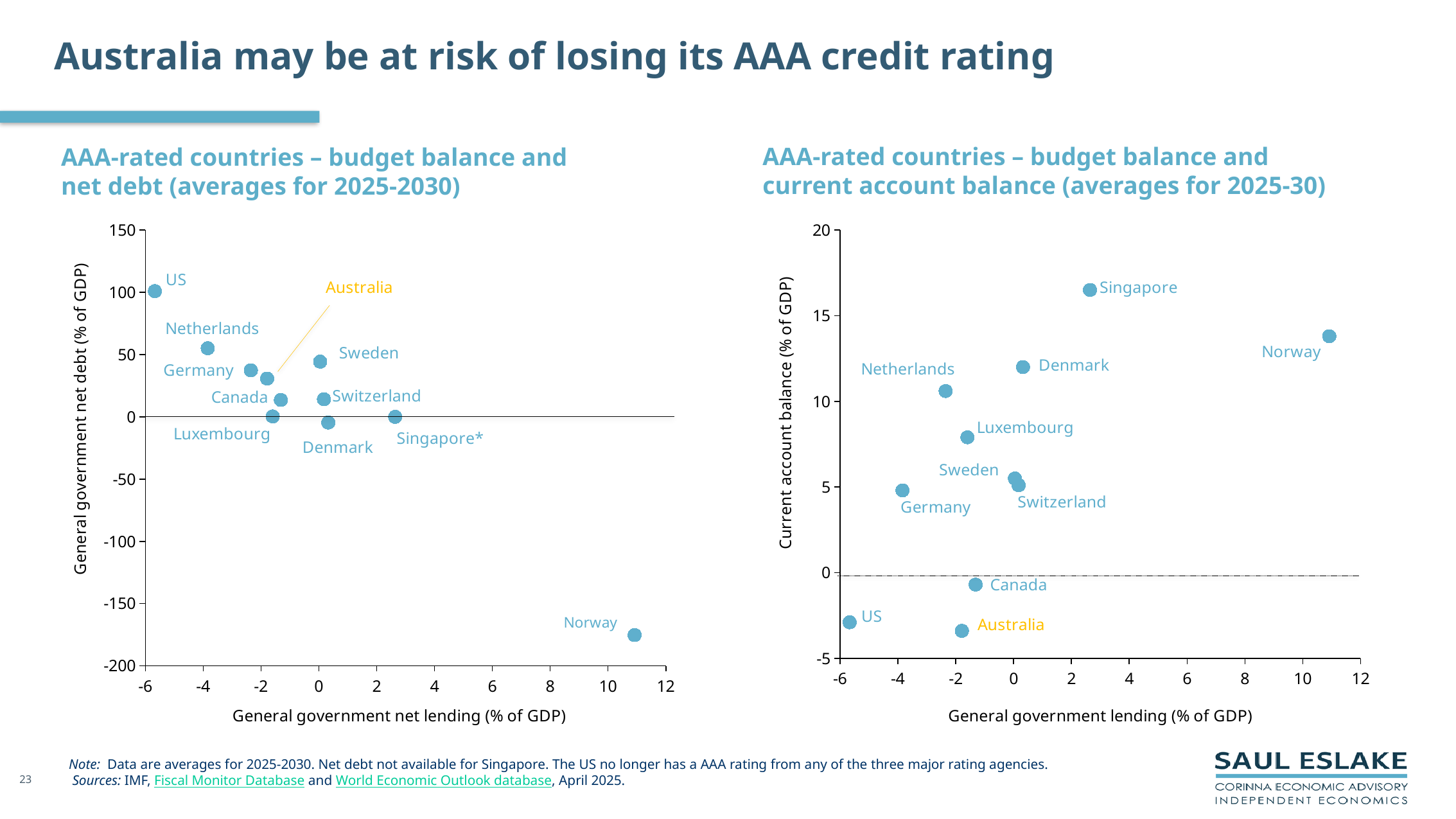
On the left chart (budget balance and net debt), is the net debt value for Norway greater or less than -150? less What kind of chart is the left chart, 'AAA-rated countries – budget balance and net debt'? Scatter chart How many countries are plotted on the right chart (budget balance and current account balance)? 11 On the right chart (budget balance and current account balance), which country has the highest general government lending? Norway On the left chart (budget balance and net debt), which country has the lowest general government net debt? Norway On the left chart (budget balance and net debt), is the net debt value for the US greater or less than 50? greater On the left chart (budget balance and net debt), which country has the highest general government net debt? US How many countries are plotted on the left chart (budget balance and net debt)? 11 Which country is labelled in a different colour (orange) from the others on both charts? Australia On the right chart (budget balance and current account balance), which has the larger current account balance, Singapore or Denmark? Singapore On the right chart (budget balance and current account balance), is the current account balance for Singapore greater or less than 15? greater On the right chart (budget balance and current account balance), which country has the highest current account balance? Singapore